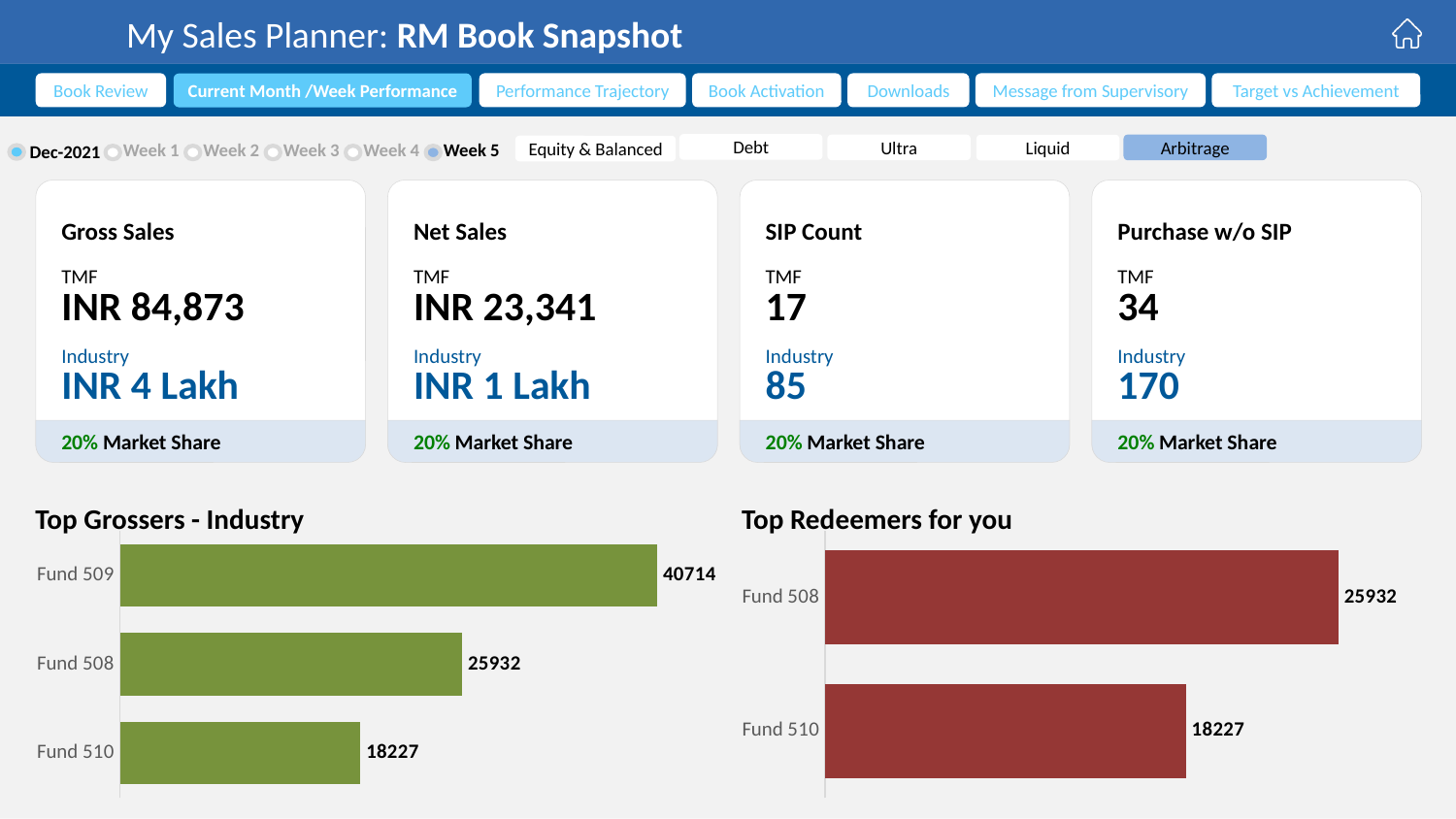
In the 'Top Redeemers for you' chart, which fund has the lowest value? Fund 510 How many funds are shown in the 'Top Grossers - Industry' chart? 3 In the 'Top Grossers - Industry' chart, what is the value for Fund 509? 40714 In the 'Top Grossers - Industry' chart, what is the value for Fund 510? 18227 In the 'Top Redeemers for you' chart, what is the value for Fund 508? 25932 How many funds are shown in the 'Top Redeemers for you' chart? 2 In the 'Top Grossers - Industry' chart, which is larger: the value for Fund 508 or Fund 510? Fund 508 In the 'Top Grossers - Industry' chart, which fund has the highest value? Fund 509 In the 'Top Grossers - Industry' chart, what is the difference between the values for Fund 509 and Fund 508? 14782 What type of chart is 'Top Redeemers for you'? Bar chart In the 'Top Redeemers for you' chart, what is the difference between the values for Fund 508 and Fund 510? 7705 What colour are the bars in the 'Top Grossers - Industry' chart? Green